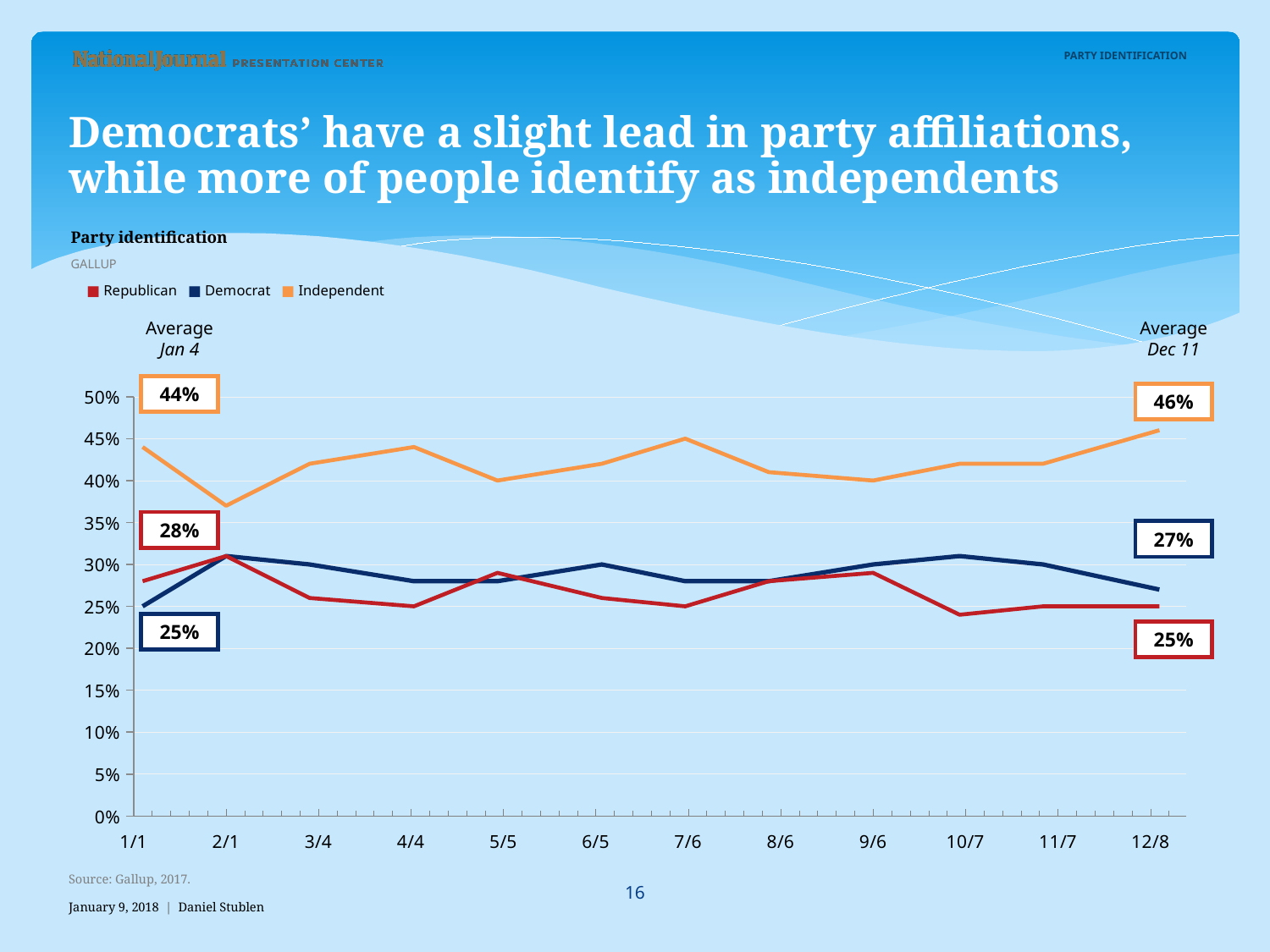
By how many percentage points did the Independent average change from Jan 4 (44%) to Dec 11 (46%)? 2 percentage points What is the Independent average labelled for Dec 11? 46% What is the Democrat average labelled for Dec 11? 27% How many series does the legend list? 3 Which party identification series is highest across the whole chart? Independent What kind of chart is shown on the slide? Line chart Is the Independent value at 2/1 greater or less than 40%? less How many date labels are shown along the x axis? 12 What is the Republican average labelled for Jan 4? 28% What colour represents Independent in the legend? Orange What is the Independent average labelled for Jan 4? 44% On the Jan 4 average, which was larger: Republican or Democrat? Republican